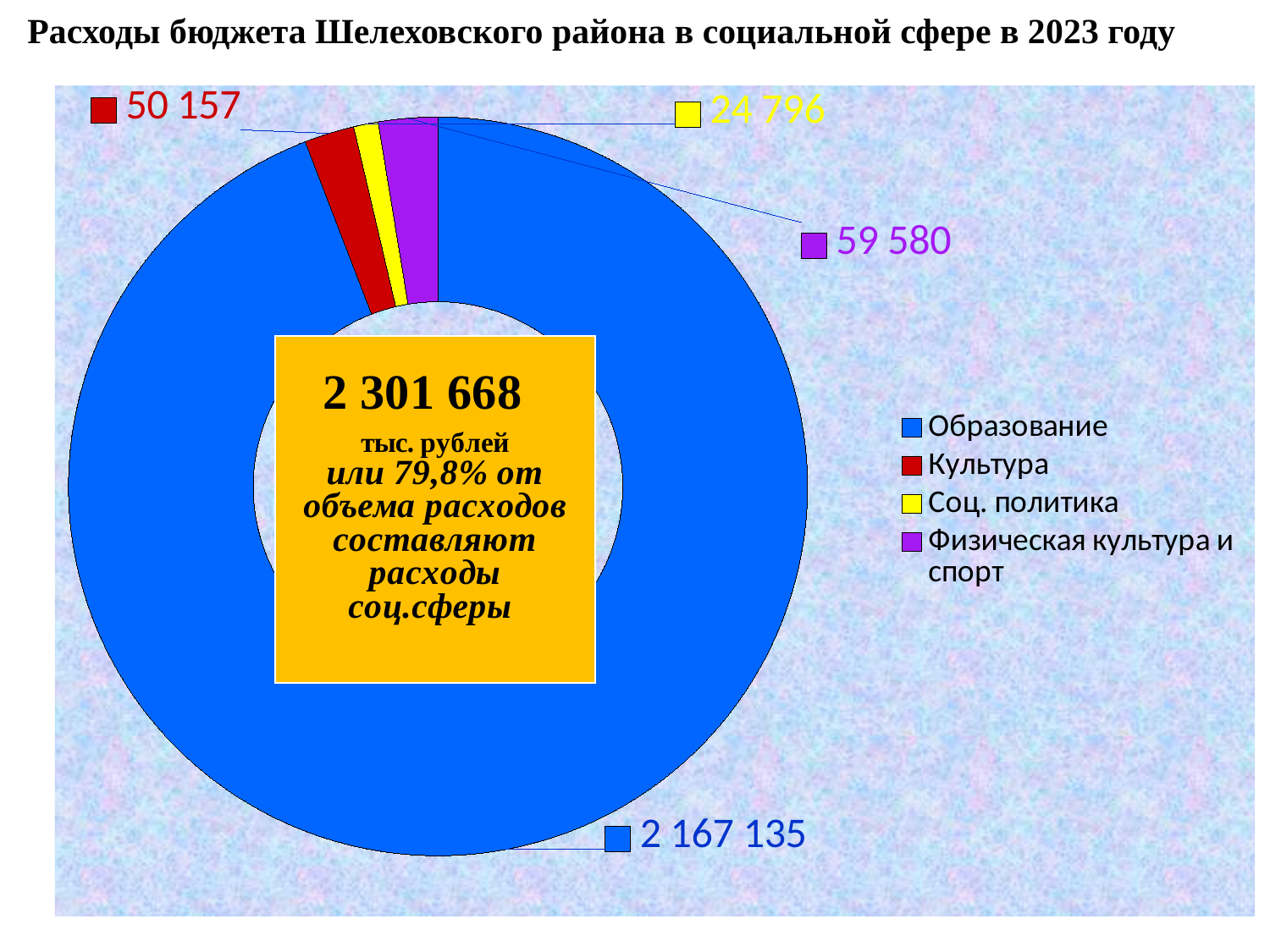
Which category has the largest value? Образование What is the value for Соц. политика? 24 796 What is the value for Образование? 2 167 135 Which category has the smallest value? Соц. политика Which is larger, the value for Культура or the value for Физическая культура и спорт? Физическая культура и спорт How many categories does the chart show? 4 What total value is printed in the centre of the chart? 2 301 668 What kind of chart is shown on the slide? Doughnut chart What is the difference between the values for Физическая культура и спорт and Культура? 9 423 What is the difference between the values for Культура and Соц. политика? 25 361 What is the value for Физическая культура и спорт? 59 580 What is the value for Культура? 50 157